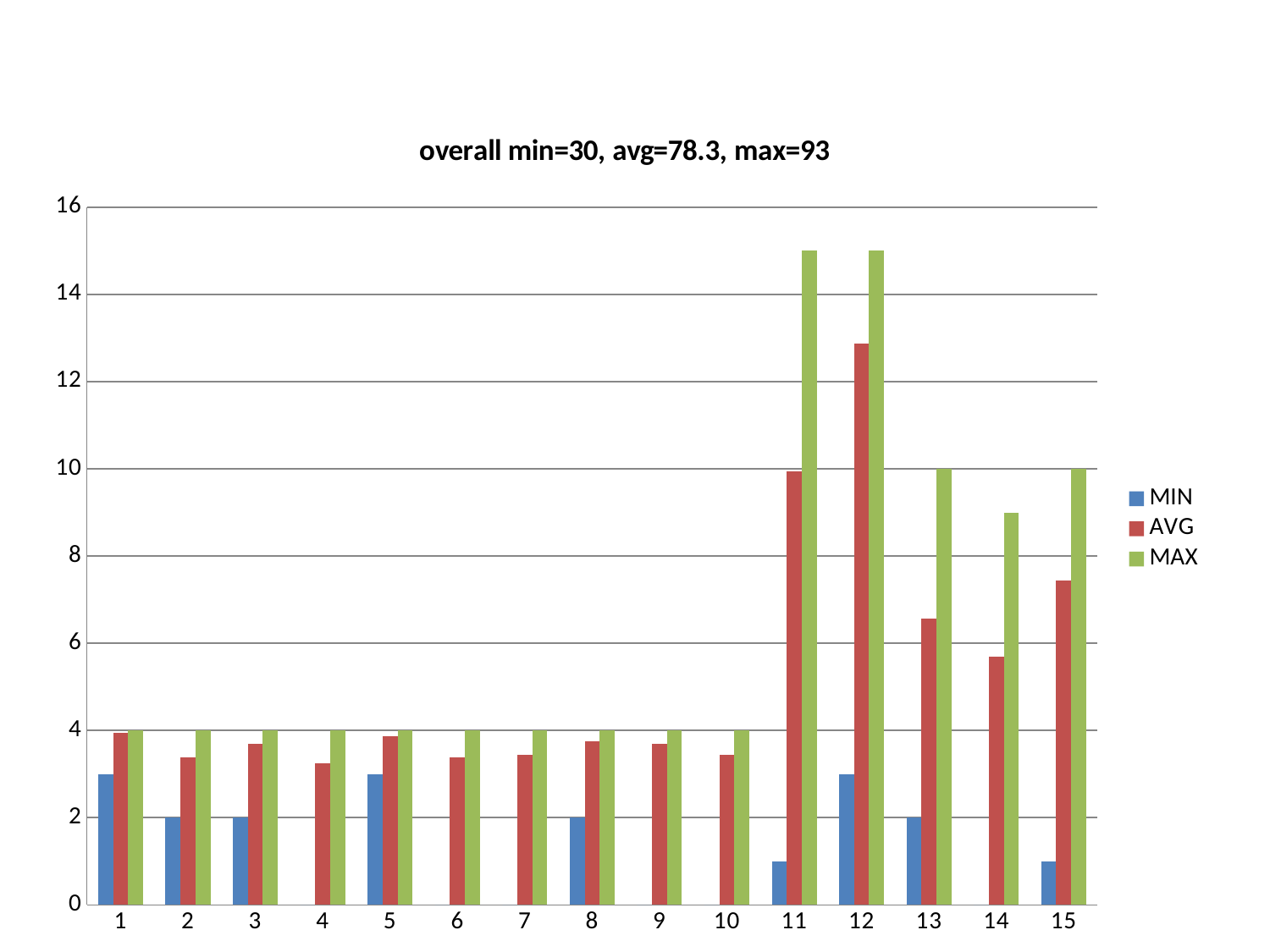
What is the chart title? overall min=30, avg=78.3, max=93 What kind of chart is shown on the slide? bar chart Which is larger, the AVG value for category 11 or for category 13? category 11 What is the MAX value for category 1? 4 Is the MAX value for category 11 greater or less than 14? greater What is the difference between the MAX value for category 13 and the MAX value for category 1? 6 How many series does the legend list? 3 What is the MIN value for category 2? 2 Which category has the highest AVG value? 12 How many categories are shown on the x axis? 15 Is the AVG value for category 14 greater or less than 6? less What is the MAX value for category 13? 10